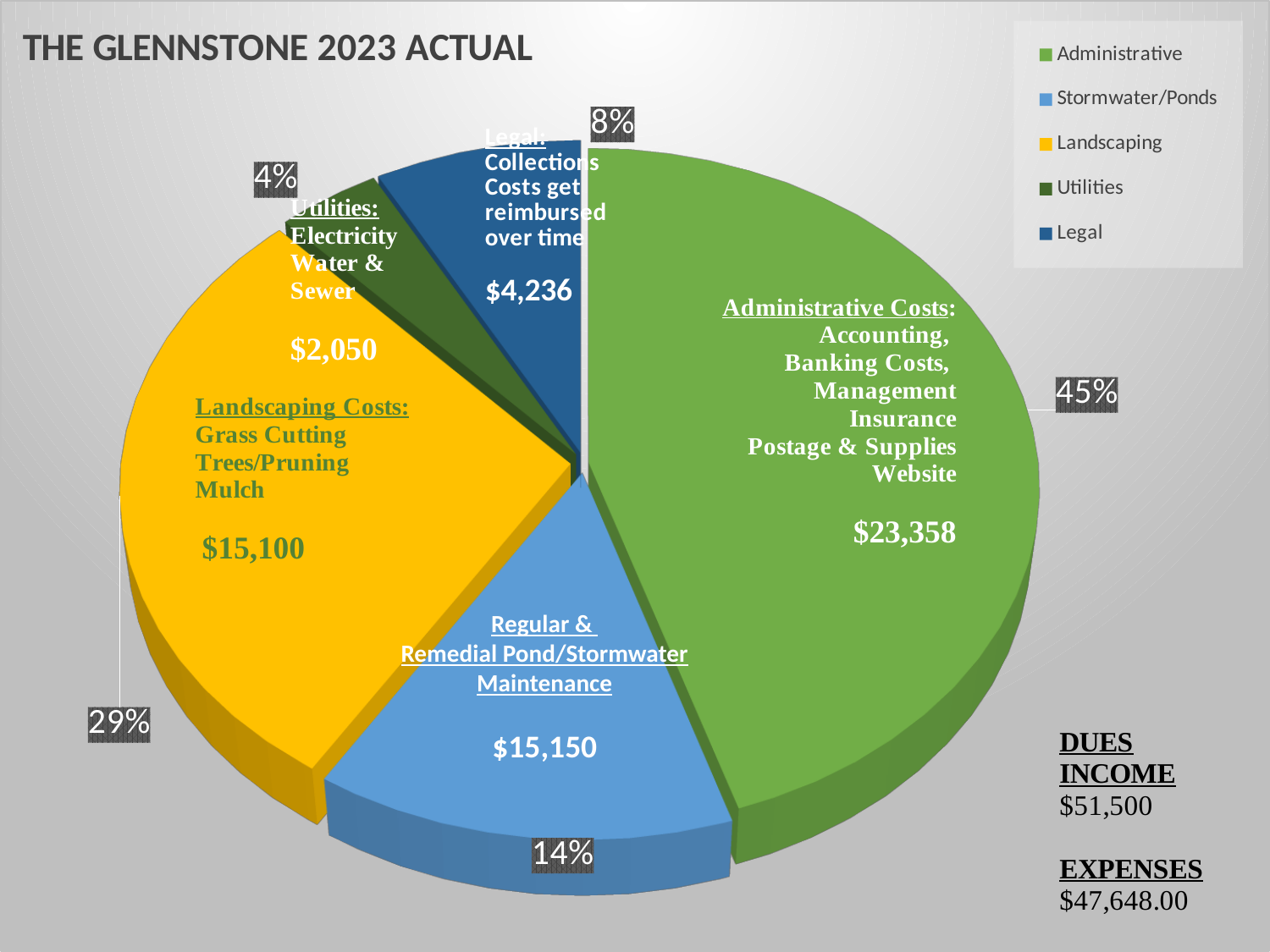
Which category has the smallest slice of the pie? Utilities What is the value shown for Legal? $4,236 What is the value shown for Utilities? $2,050 What is the title of the chart? THE GLENNSTONE 2023 ACTUAL What is the value shown for Administrative costs? $23,358 Which category has the largest slice of the pie? Administrative What kind of chart is shown on the slide? pie chart What is the difference between the Legal value and the Utilities value? $2,186 What is the value shown for Landscaping costs? $15,100 What share of the pie does Legal represent? 8% What share of the pie does Administrative represent? 45% How many categories does the legend list? 5